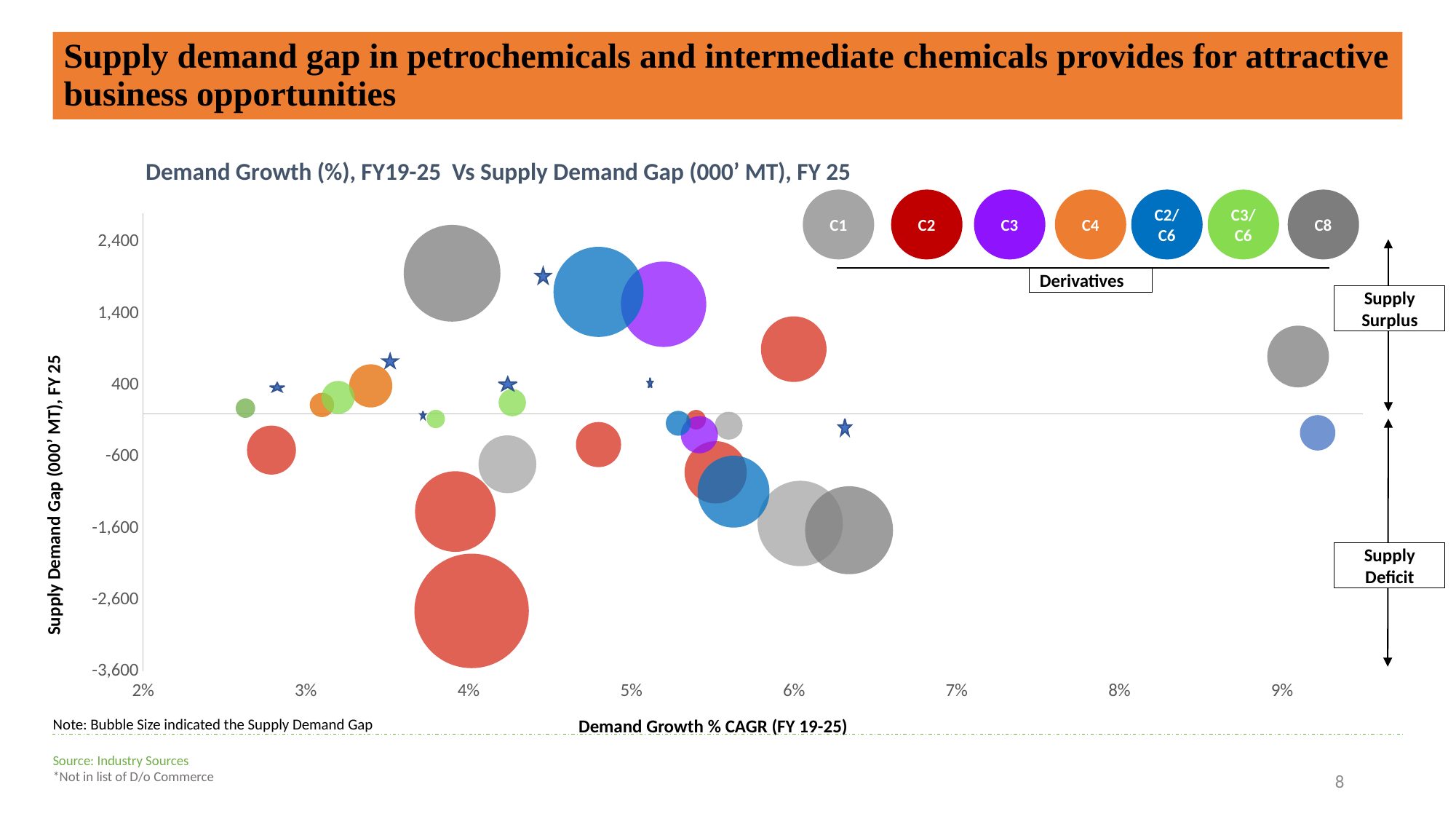
Is the value of the largest red (C2) bubble, near 4% demand growth, greater or less than -1,600? less What does the legend say the bubble size indicates? The Supply Demand Gap Is the value of the grey bubble near 9% demand growth greater or less than 1,400? less What kind of chart is shown on the slide? Bubble chart Is the value of the red bubble near 6% demand growth greater or less than 400? greater What is the title of the chart? Demand Growth (%), FY19-25 Vs Supply Demand Gap (000' MT), FY 25 Which is lower in supply demand gap: the largest red bubble near 4% demand growth or the grey bubble near 6.3% demand growth? The largest red bubble near 4% How many derivative categories does the legend list? 7 Which is larger in supply demand gap: the large grey bubble near 4% demand growth or the red bubble near 6% demand growth? The large grey bubble near 4%